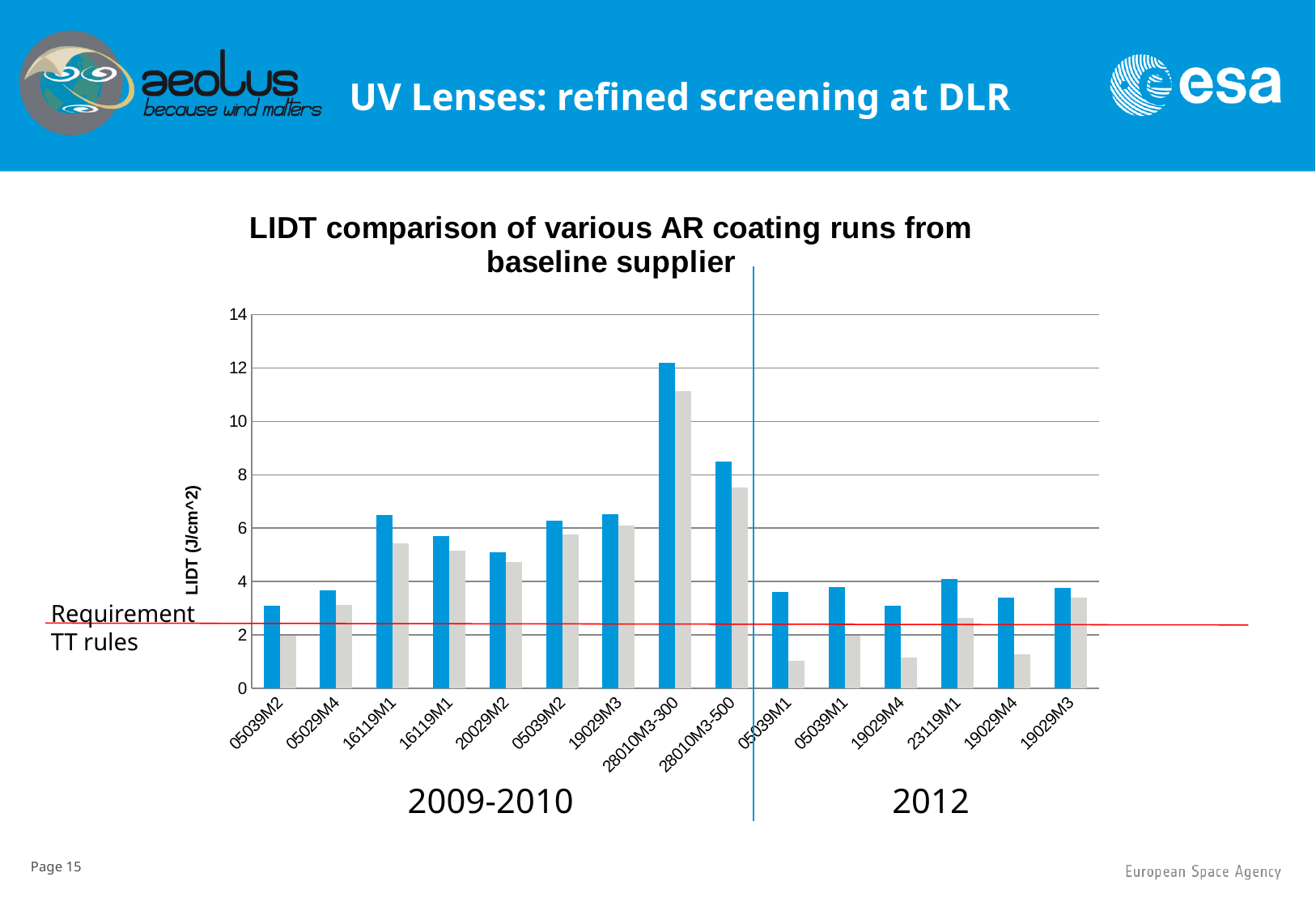
Is the blue bar for 28010M3-500 greater or less than 6? greater Is the grey bar for the first 05039M1 run in the 2012 group greater or less than 2? less What is the title of the chart? LIDT comparison of various AR coating runs from baseline supplier What is the label of the vertical axis? LIDT (J/cm^2) Is the blue bar for the first 16119M1 run greater or less than 6? greater What type of chart is shown on the slide? Bar chart Which has the larger blue bar, 28010M3-300 or 28010M3-500? 28010M3-300 What is the maximum value shown on the vertical axis? 14 How many coating run categories are shown along the x axis? 15 Which coating run has the highest LIDT value in the chart? 28010M3-300